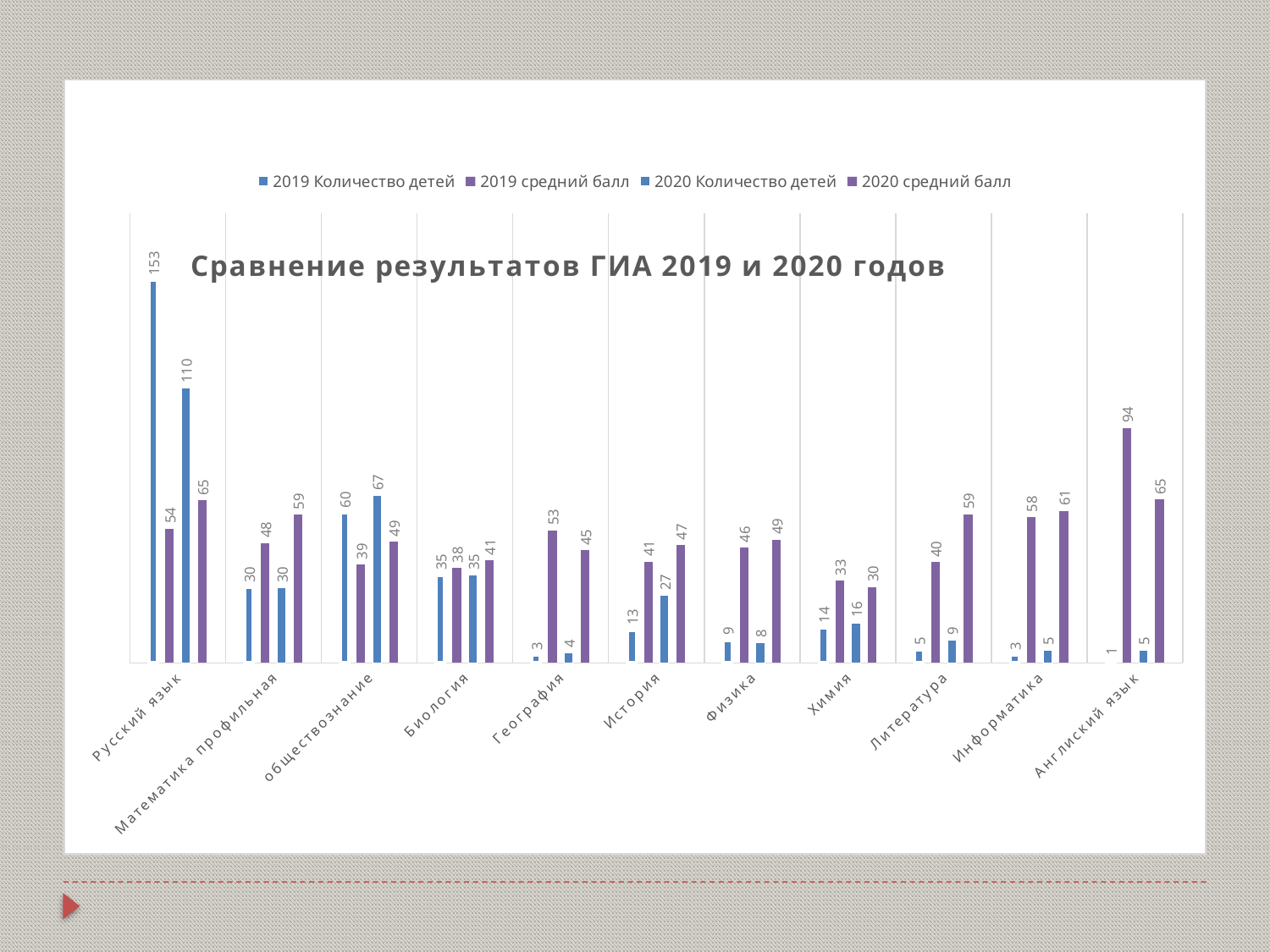
What is the 2019 Количество детей value for Русский язык? 153 What is the 2020 средний балл value for Литература? 59 Which category has the lowest 2019 Количество детей value? Английский язык How many series does the legend list? 4 How many categories are shown on the x axis? 11 What is the title of the chart? Сравнение результатов ГИА 2019 и 2020 годов What is the difference between the 2019 Количество детей and 2020 Количество детей values for Русский язык? 43 What is the 2019 средний балл value for Английский язык? 94 What is the difference between the 2020 средний балл and 2019 средний балл values for Математика профильная? 11 Which category has the highest 2020 Количество детей value? Русский язык What kind of chart is shown on the slide? Bar chart Which is larger for Химия: the 2019 средний балл or the 2020 средний балл? 2019 средний балл